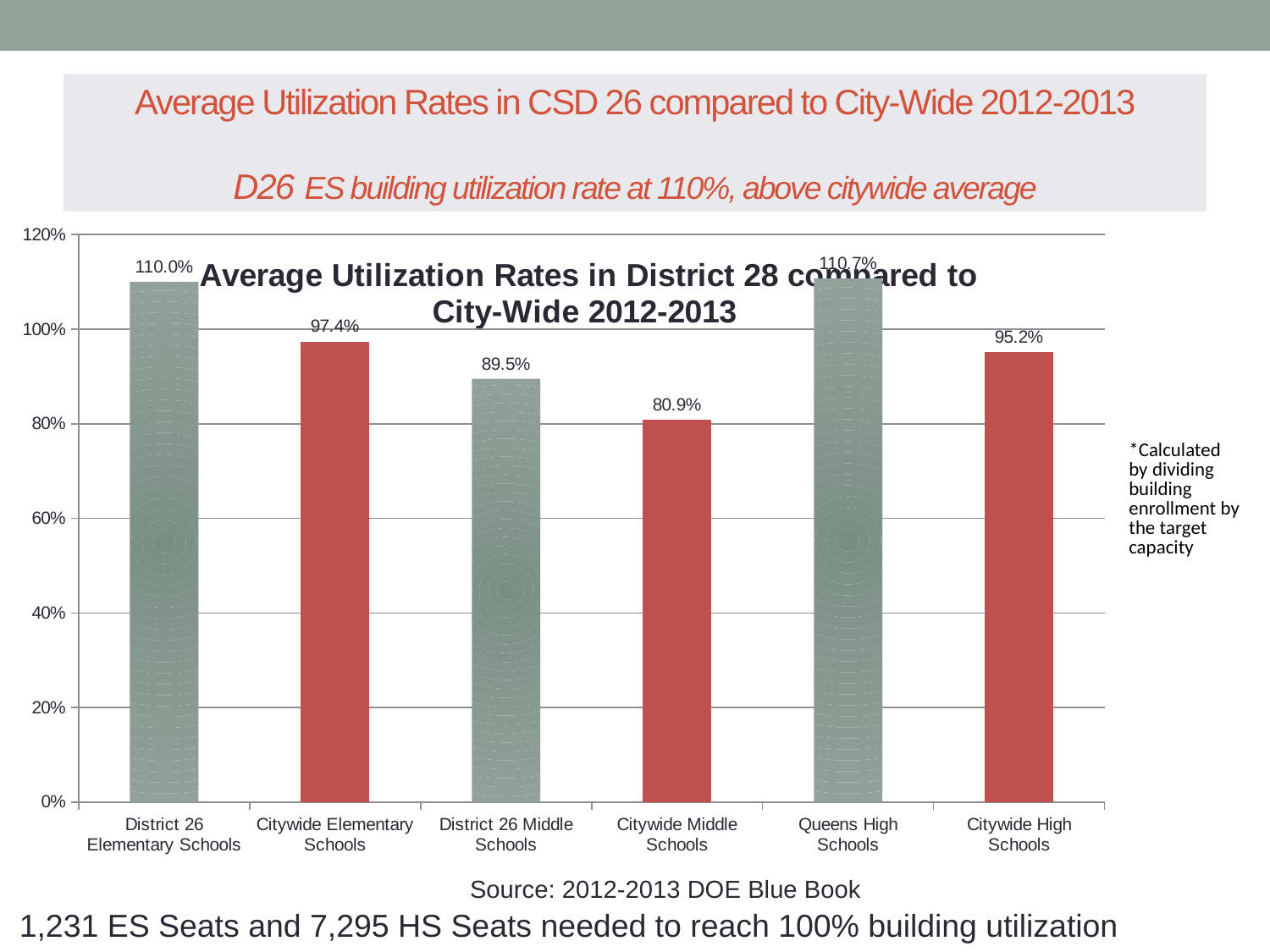
What is the average utilization rate for Queens High Schools? 110.7% What kind of chart is shown on the slide? bar chart Which has a higher utilization rate, District 26 Elementary Schools or Citywide Elementary Schools? District 26 Elementary Schools How many categories are shown on the x axis of the chart? 6 Which category has the lowest average utilization rate? Citywide Middle Schools What is the source cited below the chart? 2012-2013 DOE Blue Book Is the value for Citywide Elementary Schools greater or less than 100%? less Which category has the highest average utilization rate? Queens High Schools What is the average utilization rate for District 26 Elementary Schools? 110.0% What is the average utilization rate for Citywide High Schools? 95.2% What is the difference between the utilization rates of District 26 Middle Schools and Citywide Middle Schools? 8.6% What is the average utilization rate for Citywide Middle Schools? 80.9%